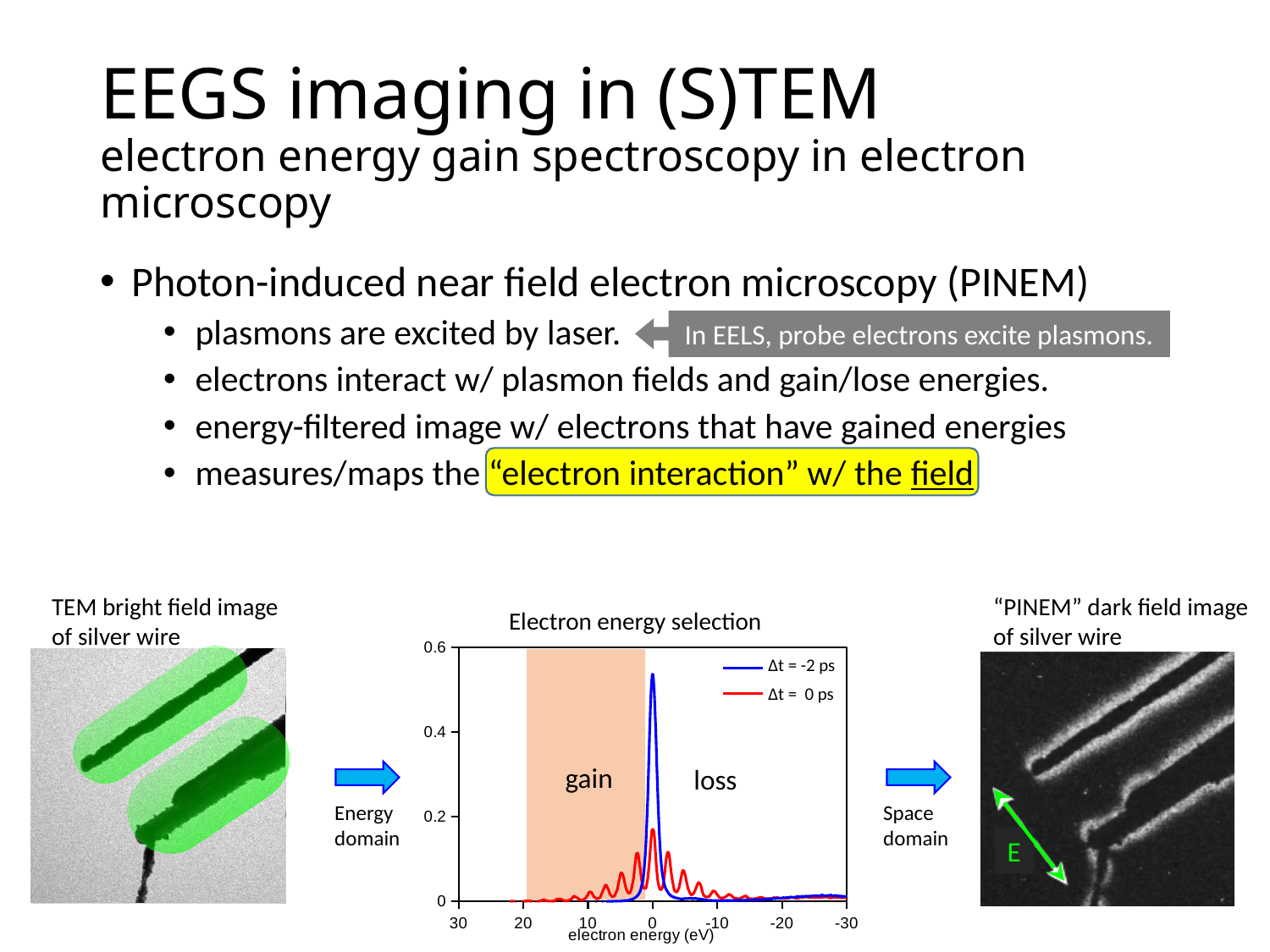
In the "Electron energy selection" chart, is the peak value of the Δt = -2 ps series greater or less than 0.6? less How many series does the legend of the "Electron energy selection" chart list? 2 In the "Electron energy selection" chart, which series has the higher peak at 0 eV, Δt = -2 ps or Δt = 0 ps? Δt = -2 ps What kind of chart is shown under the title "Electron energy selection"? line chart In the "Electron energy selection" chart, which series is drawn in blue? Δt = -2 ps In the "Electron energy selection" chart, is the peak value of the Δt = -2 ps series greater or less than 0.4? greater What is the x-axis label of the "Electron energy selection" chart? electron energy (eV) In the "Electron energy selection" chart, at what electron energy does the Δt = -2 ps series reach its maximum? 0 In the "Electron energy selection" chart, what is the highest value shown on the y-axis? 0.6 In the "Electron energy selection" chart, is the peak value of the Δt = 0 ps series greater or less than 0.2? less